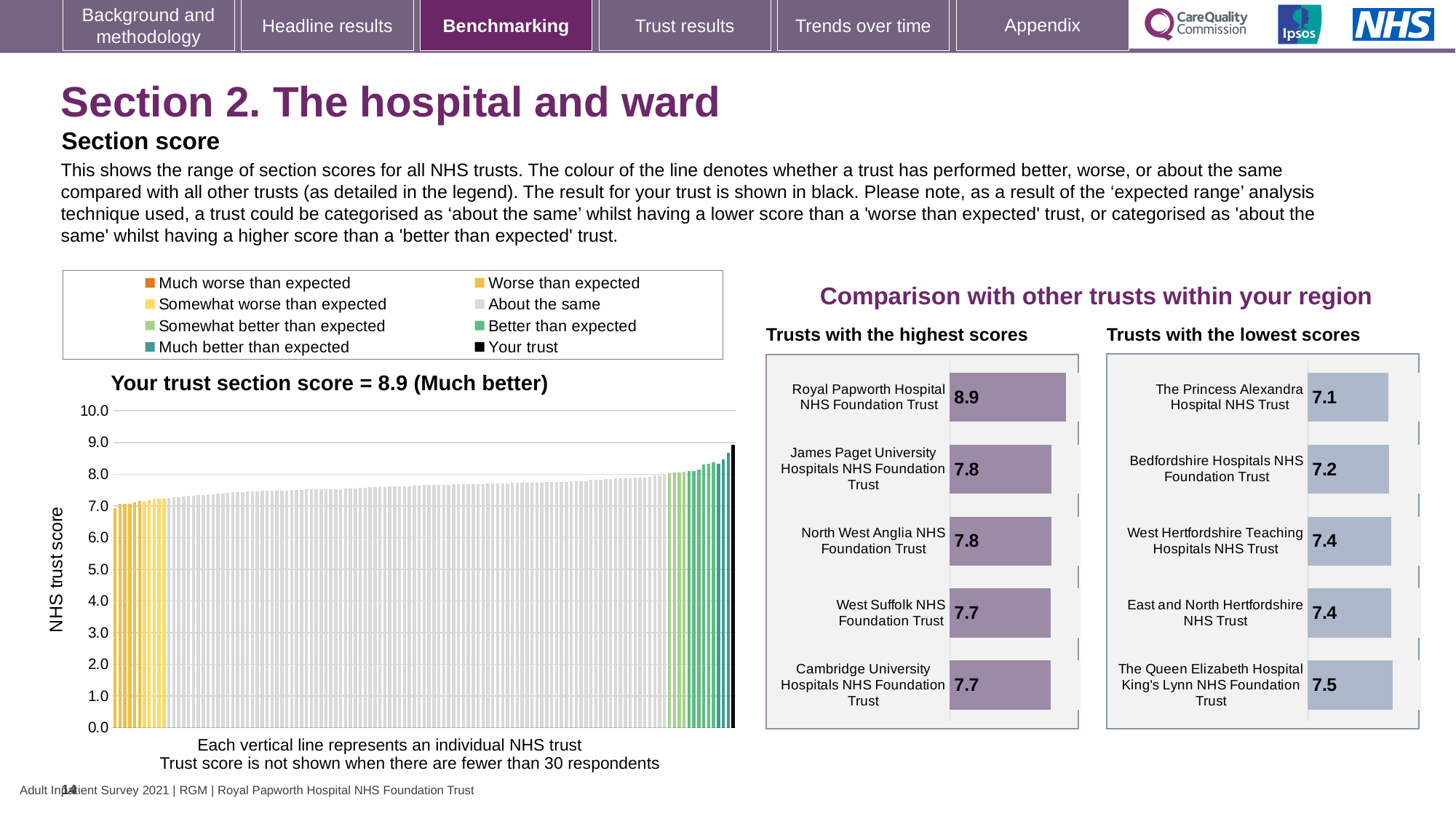
In the 'Trusts with the lowest scores' chart, what is the difference between the scores of The Queen Elizabeth Hospital King's Lynn NHS Foundation Trust and The Princess Alexandra Hospital NHS Trust? 0.4 In the 'Your trust section score' chart, do the bar values rise or fall from left to right along the x axis? rise What kind of chart is the 'Your trust section score' chart? bar chart In the 'Trusts with the lowest scores' chart, which trust has the lowest score? The Princess Alexandra Hospital NHS Trust In the 'Your trust section score' chart, is the value for your trust (the black bar) greater or less than 8.0? greater In the 'Trusts with the highest scores' chart, what is the score for Royal Papworth Hospital NHS Foundation Trust? 8.9 In the 'Trusts with the highest scores' chart, which trust has the highest score? Royal Papworth Hospital NHS Foundation Trust In the 'Trusts with the highest scores' chart, what is the score for West Suffolk NHS Foundation Trust? 7.7 In the 'Trusts with the lowest scores' chart, what is the score for Bedfordshire Hospitals NHS Foundation Trust? 7.2 In the 'Trusts with the lowest scores' chart, which has the larger score: Bedfordshire Hospitals NHS Foundation Trust or West Hertfordshire Teaching Hospitals NHS Trust? West Hertfordshire Teaching Hospitals NHS Trust How many trusts are listed in the 'Trusts with the lowest scores' chart? 5 In the 'Trusts with the highest scores' chart, what is the difference between the scores of Royal Papworth Hospital NHS Foundation Trust and Cambridge University Hospitals NHS Foundation Trust? 1.2